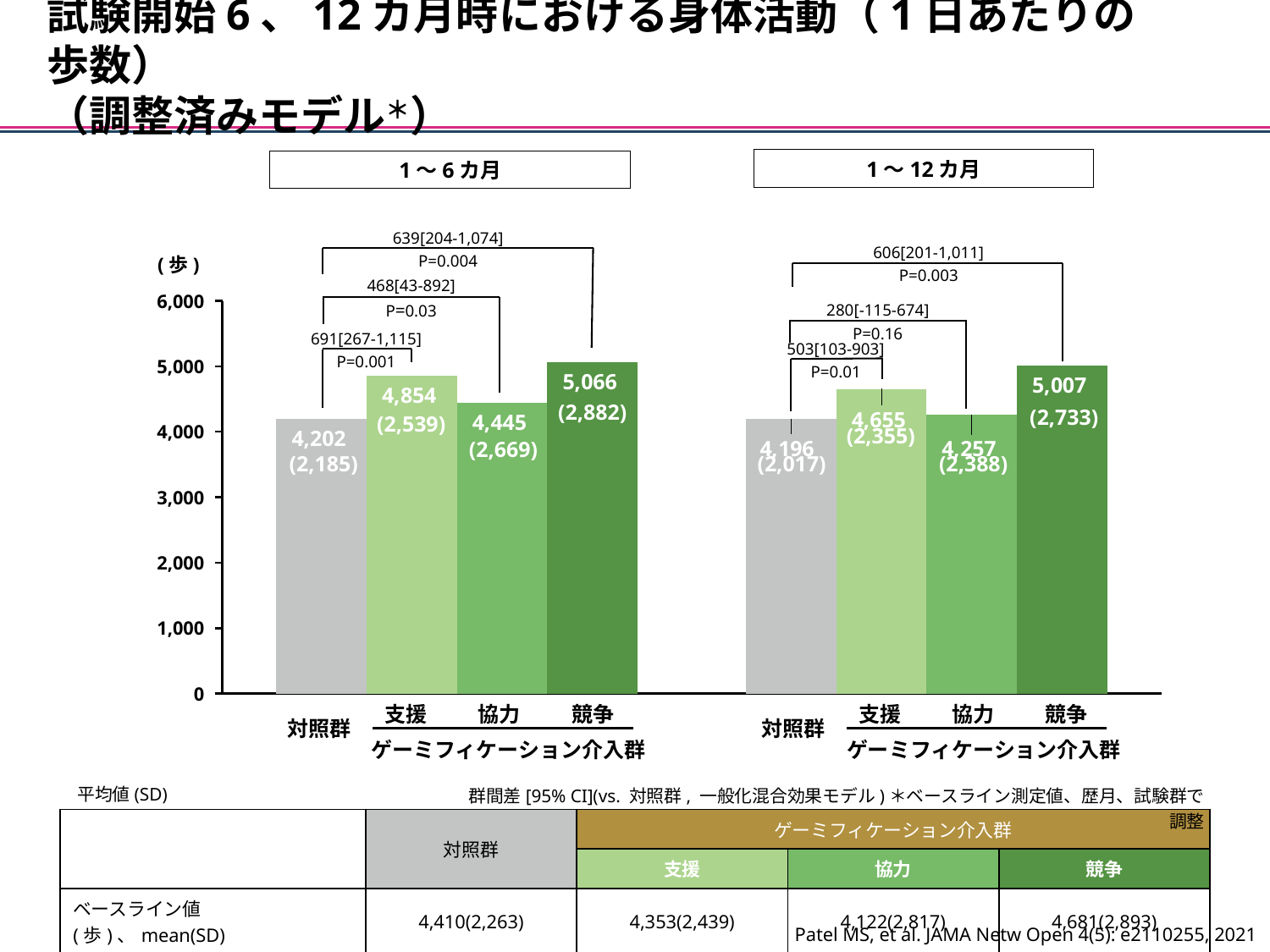
In the 1～6カ月 chart, what is the mean step value shown for the 競争 group? 5,066 In the 1～12カ月 chart, which is larger, the mean value for 支援 or for 協力? 支援 In the 1～6カ月 chart, which group has the highest bar? 競争 In the 1～6カ月 chart, what P value is shown for the comparison between the 競争 group and the 対照群? P=0.004 In the 1～12カ月 chart, what SD value is printed in parentheses for the 協力 group? 2,388 In the 1～12カ月 chart, what is the mean step value shown for the 支援 group? 4,655 In the 1～6カ月 chart, what is the mean step value shown for the 対照群 bar? 4,202 In the 1～12カ月 chart, what is the difference between the mean values of the 支援 group and the 協力 group? 398 In the 1～6カ月 chart, what is the difference between the mean values of the 競争 group and the 対照群? 864 In the 1～12カ月 chart, which group has the lowest bar? 対照群 How many bars are plotted in the 1～6カ月 chart? 4 What kind of chart is used on this slide? Bar chart